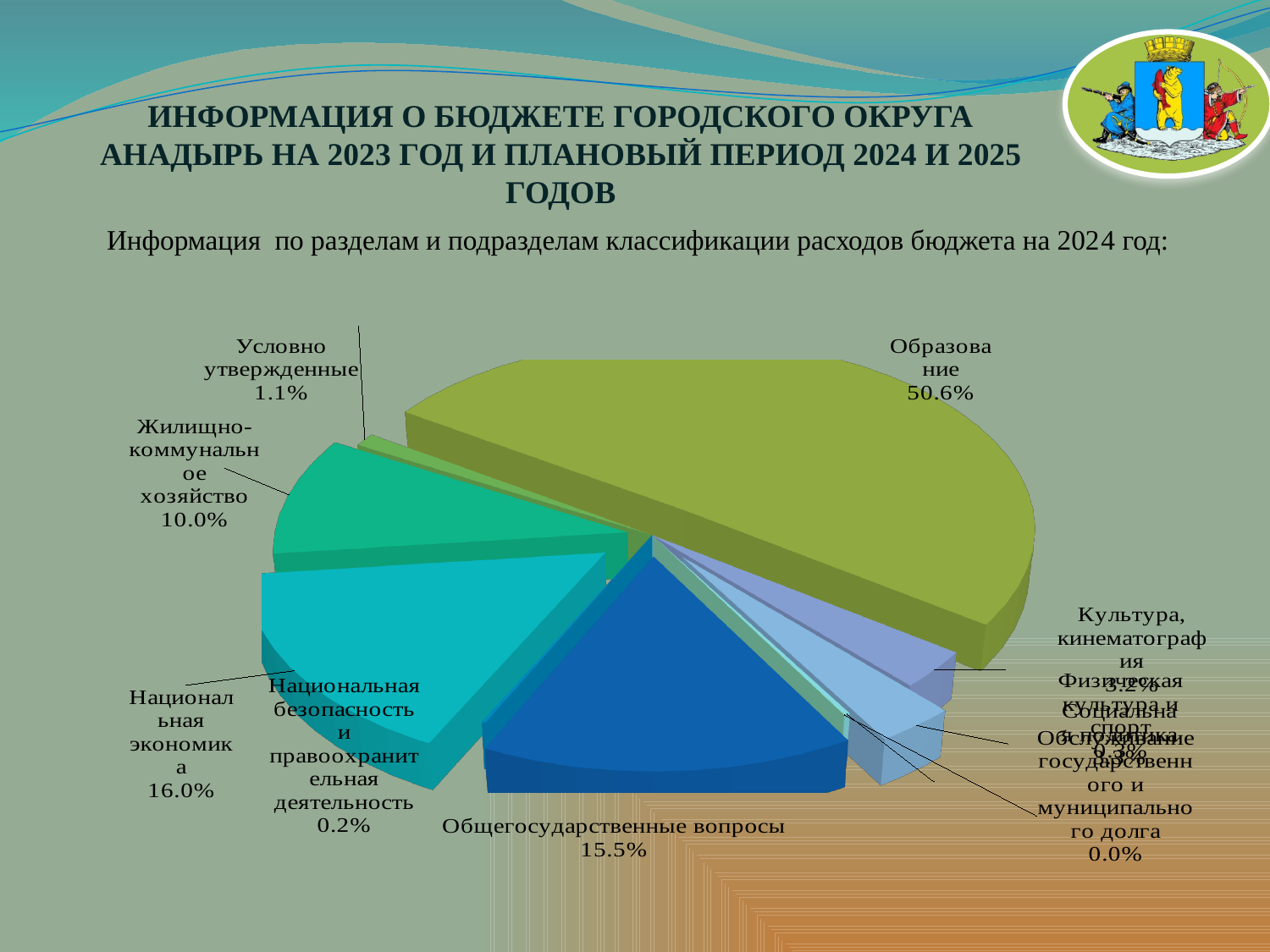
What percentage is shown for Общегосударственные вопросы? 15.5% Which category has the smallest share shown on the chart? Обслуживание государственного и муниципального долга What share of the 2024 budget expenditure goes to Образование? 50.6% What is the value shown for Национальная экономика? 16.0% What is the difference between the shares of Образование and Национальная экономика? 34.6% What percentage is labelled for Условно утвержденные? 1.1% Which category has the largest share of the pie? Образование Which is larger, Национальная экономика or Общегосударственные вопросы? Национальная экономика What type of chart is shown on the slide? pie chart What share is shown for Культура, кинематография? 3.2% What is the value for Жилищно-коммунальное хозяйство? 10.0% What is the value for Национальная безопасность и правоохранительная деятельность? 0.2%